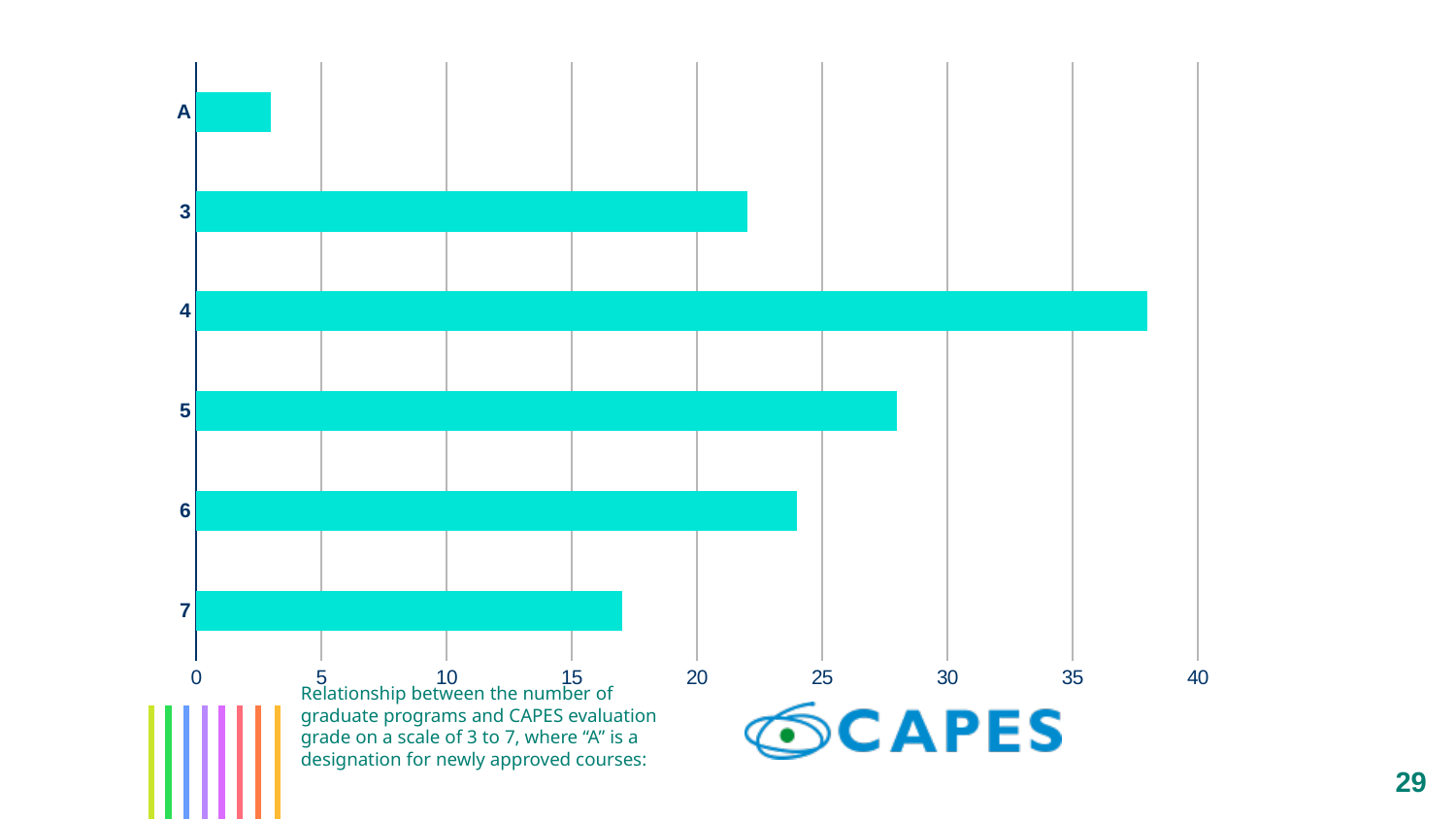
Is the value for category 3 greater or less than 20? greater How many categories are plotted on the chart? 6 Which category has the lowest value? A Is the value for category 5 greater or less than 25? greater What kind of chart is shown on the slide? bar chart Which has the larger value, category 5 or category 6? 5 Is the value for category 7 greater or less than 20? less Which has the larger value, category 3 or category 7? 3 According to the caption, what does the category "A" designate? newly approved courses Which category has the highest value? 4